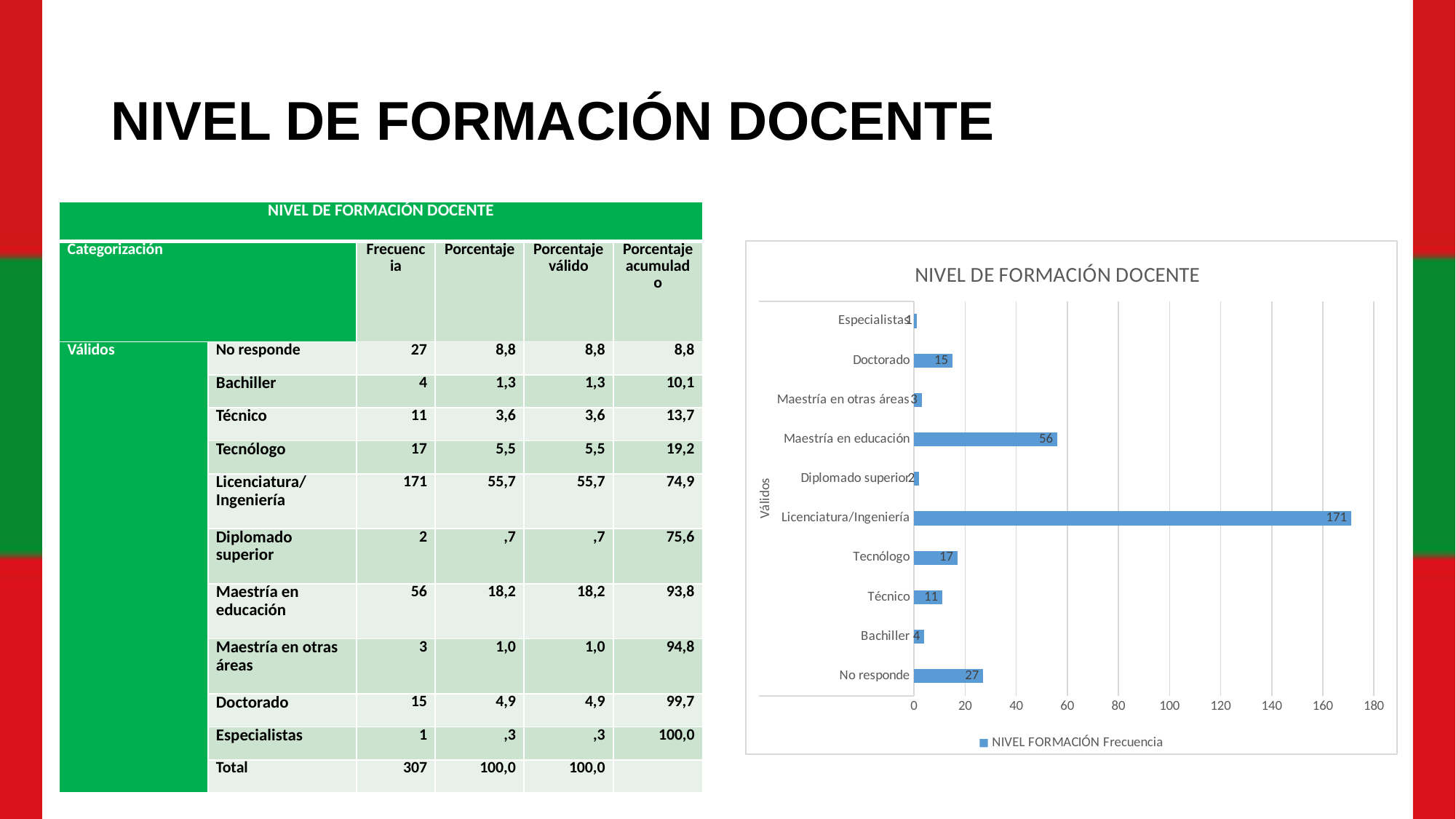
How many categories are shown in the chart? 10 What is the value for Licenciatura/Ingeniería in the chart? 171 How many series does the chart legend list? 1 What is the value for Maestría en educación in the chart? 56 What type of chart is shown on the slide? Bar chart What is the value for No responde in the chart? 27 What is the value for Doctorado in the chart? 15 Which category has the highest value in the chart? Licenciatura/Ingeniería What is the difference between the values for Licenciatura/Ingeniería and Maestría en educación? 115 Which is larger, the value for Tecnólogo or the value for Técnico? Tecnólogo Which category has the lowest value in the chart? Especialistas What is the title of the chart? NIVEL DE FORMACIÓN DOCENTE